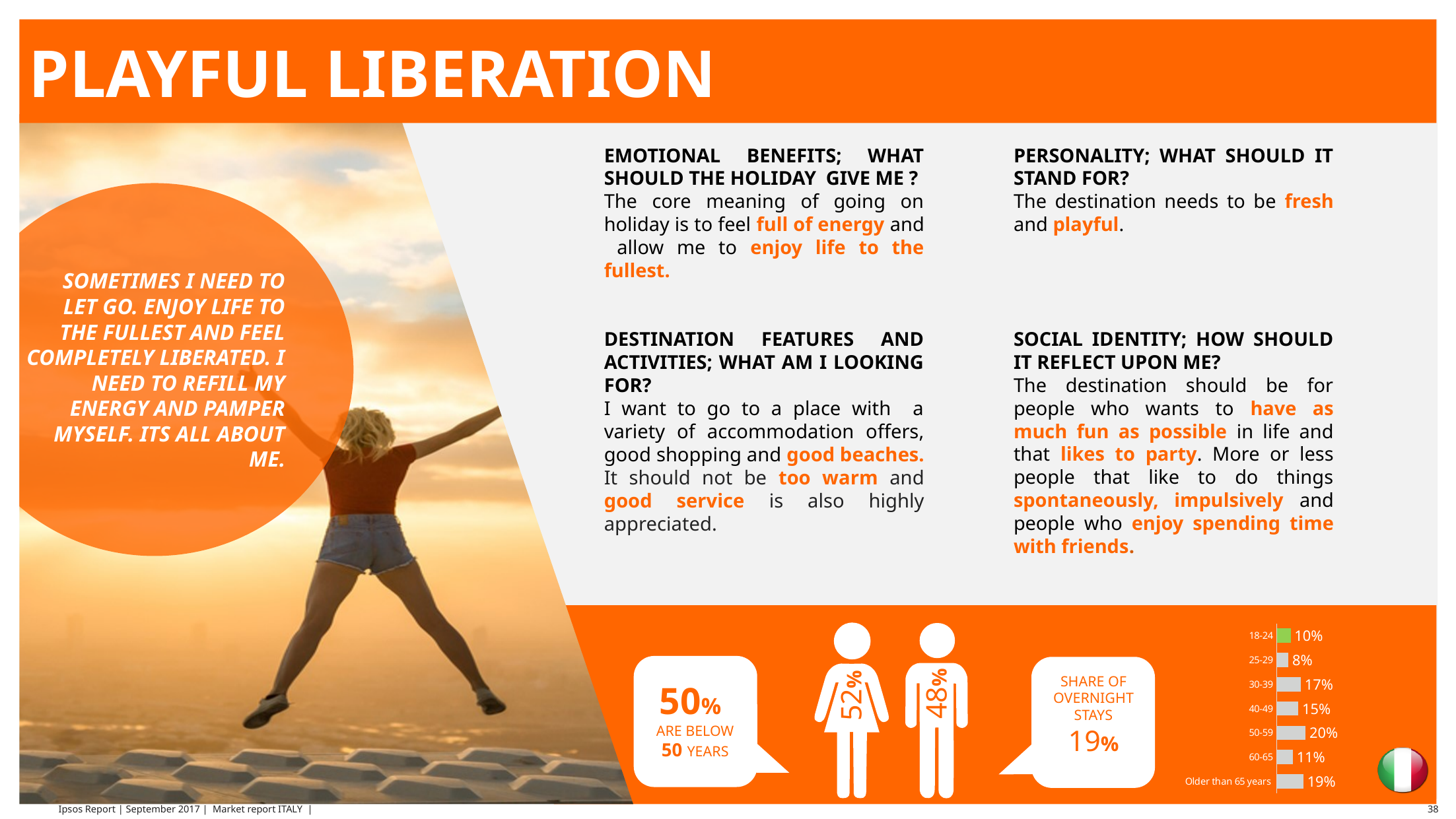
In the age-group bar chart, what is the value for the 30-39 age group? 17% In the age-group bar chart, what is the value for the 25-29 age group? 8% In the age-group bar chart, which bar is coloured green rather than grey? 18-24 In the age-group bar chart, what is the value for people older than 65 years? 19% According to the infographic, what percentage of the segment is female? 52% In the age-group bar chart, which is larger, the value for 40-49 or the value for 18-24? 40-49 In the age-group bar chart, which age group has the lowest value? 25-29 How many age groups are shown in the age-group bar chart? 7 What kind of chart is used to show the age-group breakdown? bar chart In the age-group bar chart, what is the combined value of the 18-24 and 25-29 age groups? 18% In the age-group bar chart, what is the difference between the 50-59 and 60-65 age groups? 9% In the age-group bar chart, which age group has the highest value? 50-59